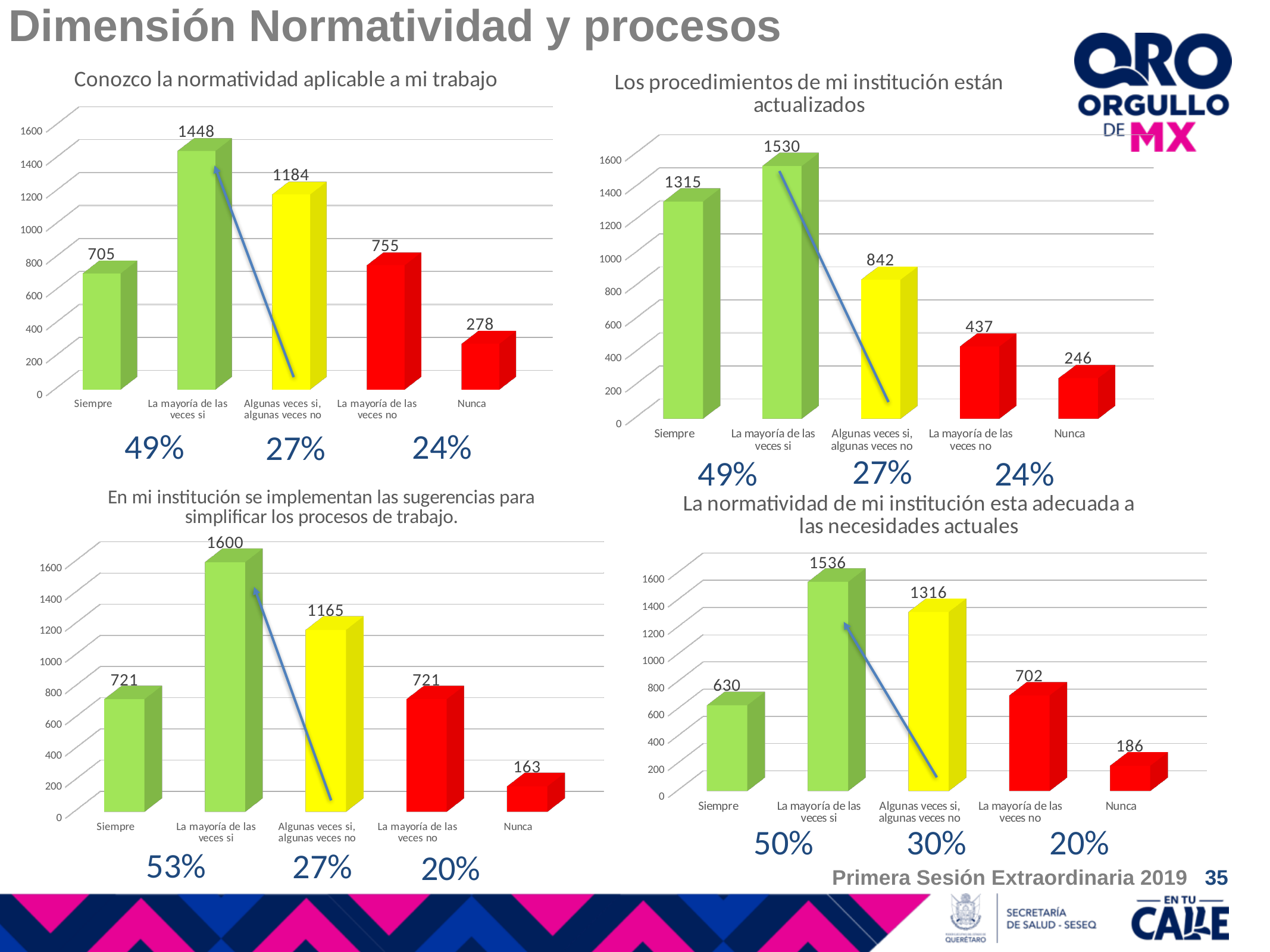
In the bottom-left chart about implementing suggestions to simplify work processes, what is the value for "Nunca"? 163 In the chart titled "Los procedimientos de mi institución están actualizados", what is the value for "Siempre"? 1315 In the chart titled "Los procedimientos de mi institución están actualizados", which category has the highest value? La mayoría de las veces si In the bottom-left chart about implementing suggestions to simplify work processes, which is larger: "Siempre" or "La mayoría de las veces no"? They are equal (721) In the chart titled "La normatividad de mi institución esta adecuada a las necesidades actuales", what is the difference between "La mayoría de las veces no" and "Nunca"? 516 What kind of chart is the top-left chart titled "Conozco la normatividad aplicable a mi trabajo"? Bar chart In the chart titled "Los procedimientos de mi institución están actualizados", what is the difference between "La mayoría de las veces si" and "Algunas veces si, algunas veces no"? 688 In the bottom-left chart about implementing suggestions to simplify work processes, how many categories are shown on the x axis? 5 In the chart titled "Conozco la normatividad aplicable a mi trabajo", which is larger: "Siempre" or "La mayoría de las veces no"? La mayoría de las veces no In the chart titled "La normatividad de mi institución esta adecuada a las necesidades actuales", what is the value for "Algunas veces si, algunas veces no"? 1316 In the chart titled "Conozco la normatividad aplicable a mi trabajo", which category has the lowest value? Nunca In the chart titled "Conozco la normatividad aplicable a mi trabajo", what is the value for "La mayoría de las veces si"? 1448